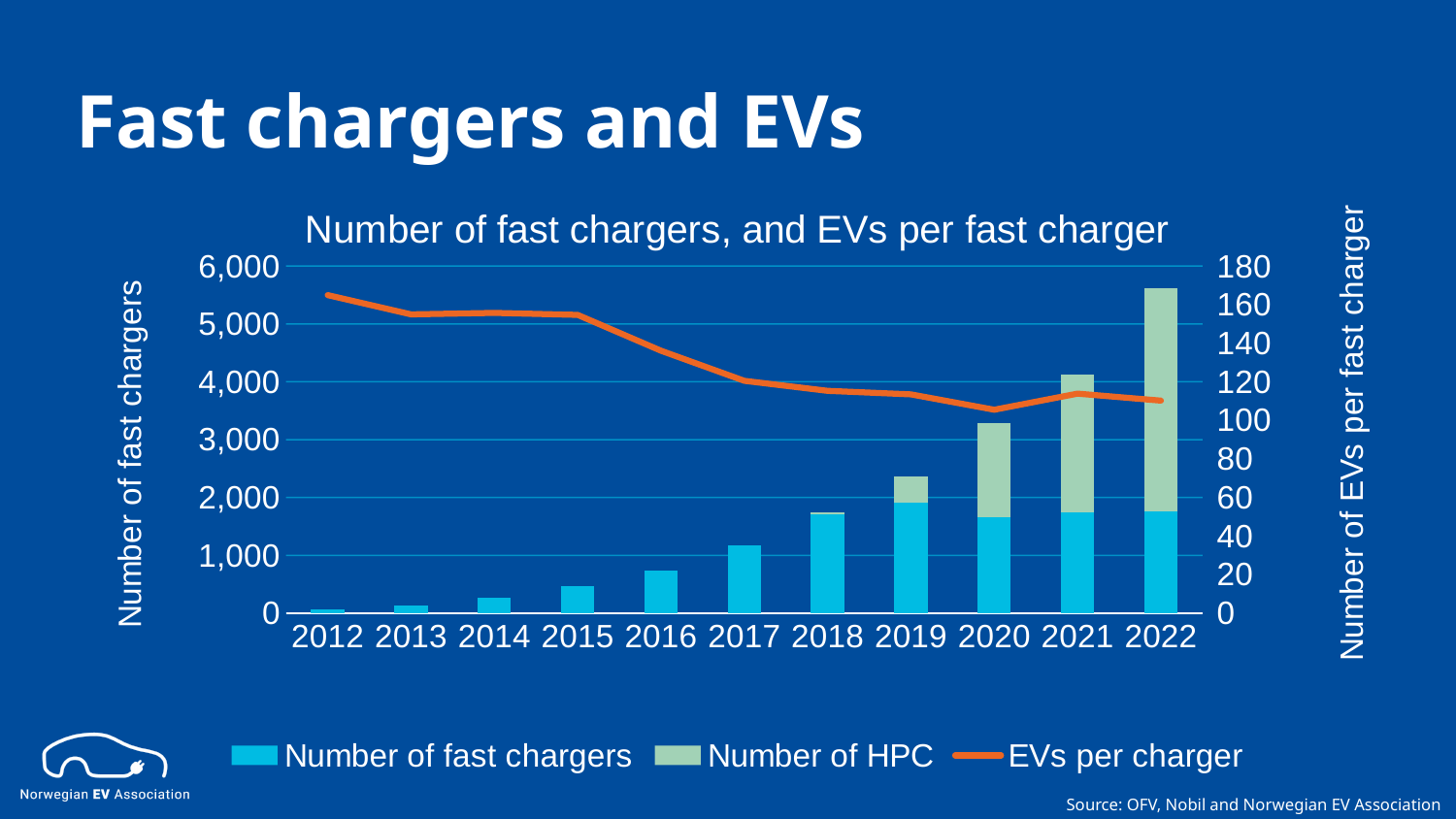
What kind of chart is shown on the slide? A bar chart combined with a line How many series does the chart legend list? 3 Is the value of EVs per charger in 2012 greater or less than 140? greater Does the EVs per charger line rise or fall from 2012 to 2020? It falls Which year has the tallest stacked bar in the chart? 2022 Which year has the shortest bar in the chart? 2012 Is the number of fast chargers (blue bar) in 2017 greater or less than 1,000? greater How many years are shown on the x axis of the chart? 11 Is the total height of the stacked bar for 2022 greater or less than 5,000? greater Which year has the taller stacked bar, 2020 or 2021? 2021 What is the title of the chart? Number of fast chargers, and EVs per fast charger